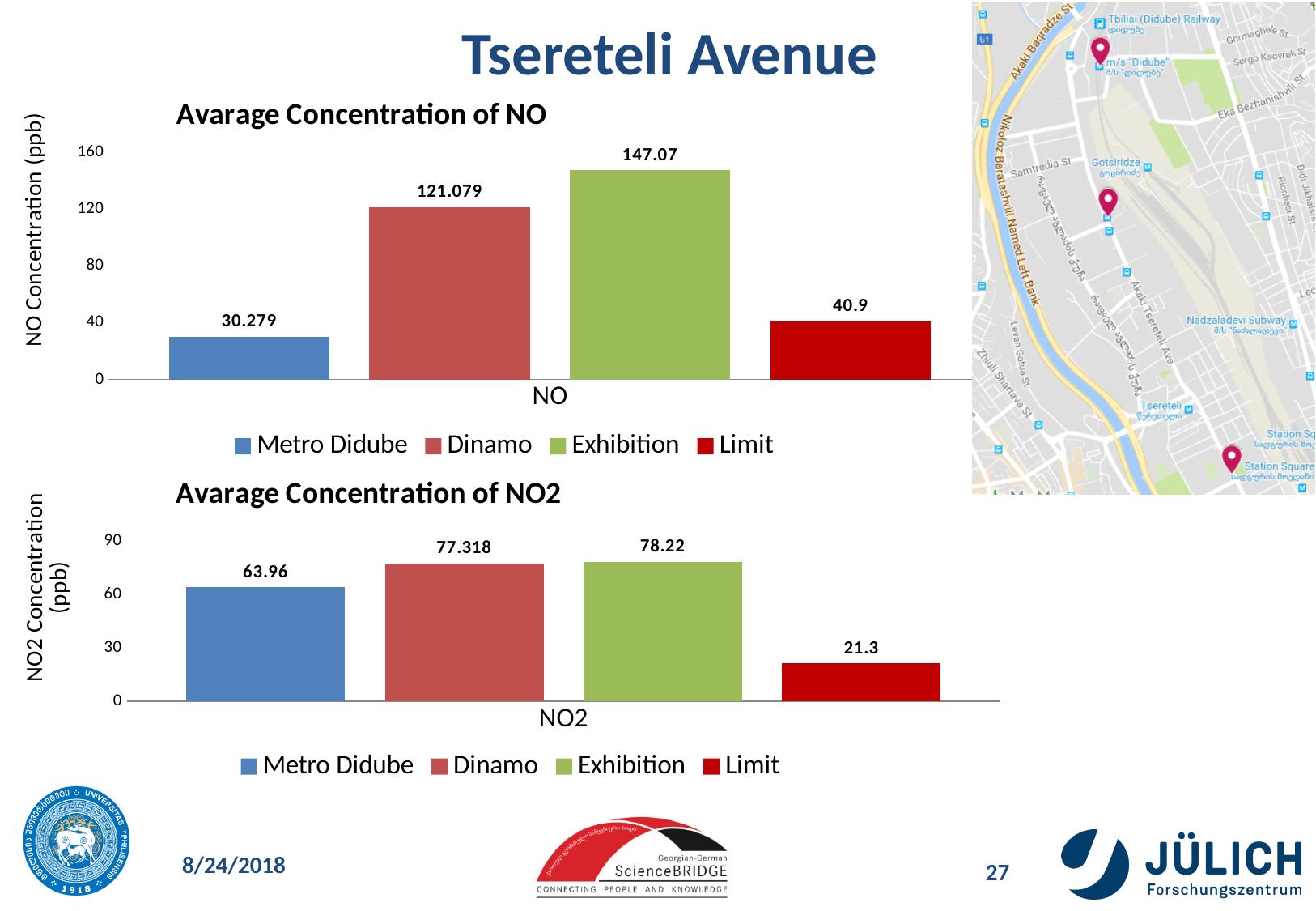
In the 'Avarage Concentration of NO' chart, which series has the highest value? Exhibition What kind of chart is the 'Avarage Concentration of NO2' chart? bar chart In the 'Avarage Concentration of NO' chart, what is the value for Exhibition? 147.07 In the 'Avarage Concentration of NO2' chart, what is the value for Limit? 21.3 In the 'Avarage Concentration of NO2' chart, is the value for Metro Didube larger or smaller than the value for Dinamo? smaller In the 'Avarage Concentration of NO2' chart, what is the difference between the Metro Didube value and the Limit value? 42.66 In the 'Avarage Concentration of NO' chart, which series has the lowest value? Metro Didube In the 'Avarage Concentration of NO' chart, how many series does the legend list? 4 In the 'Avarage Concentration of NO' chart, what is the value for Metro Didube? 30.279 In the 'Avarage Concentration of NO2' chart, what is the value for Dinamo? 77.318 In the 'Avarage Concentration of NO' chart, what is the difference between the Exhibition value and the Limit value? 106.17 In the 'Avarage Concentration of NO2' chart, which series has the lowest value? Limit